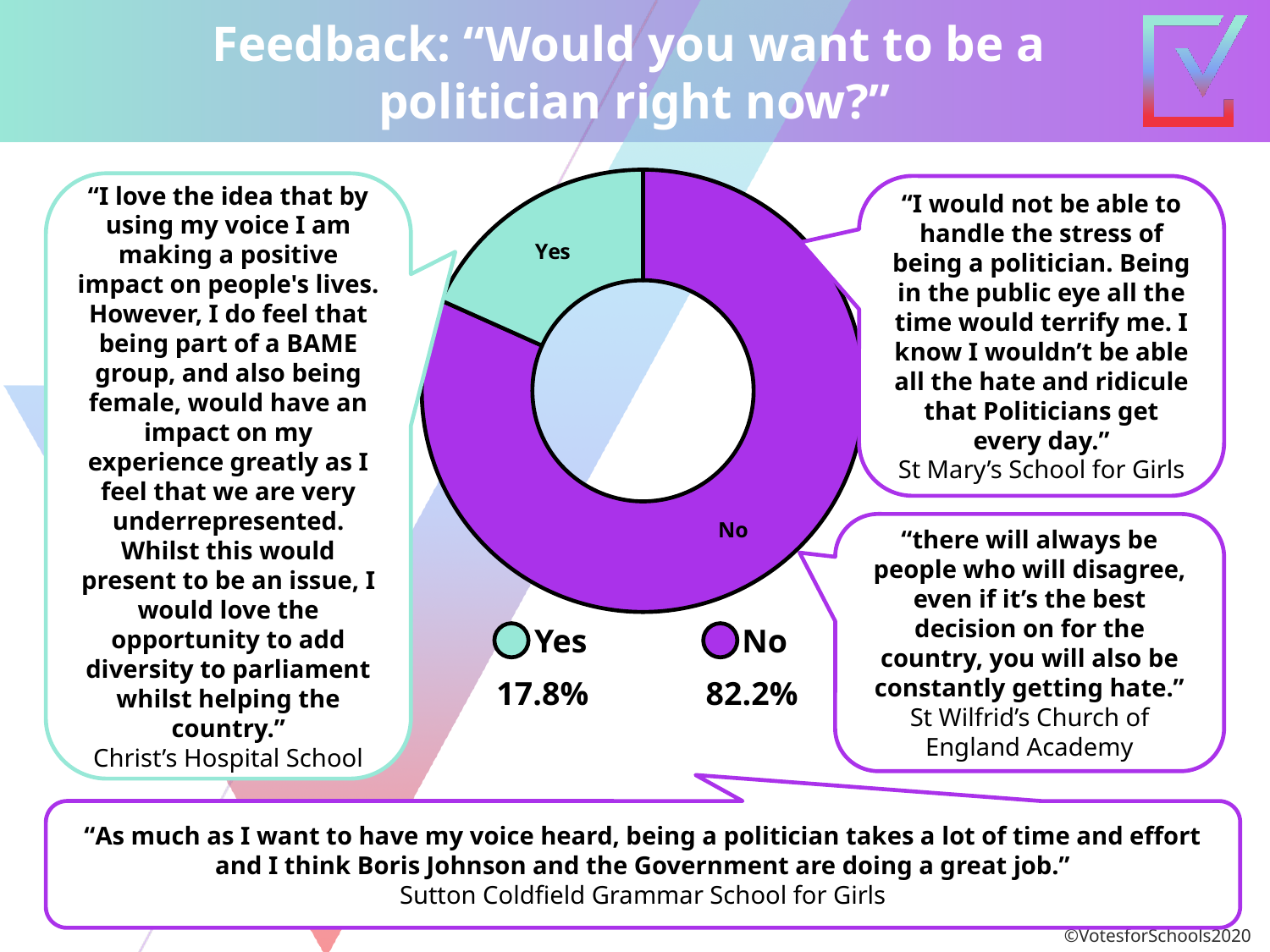
How many entries does the legend list? 2 What kind of chart is shown on the slide? Pie chart (doughnut) What is the total of the two percentages shown in the chart? 100% Which is larger, the share for "Yes" or the share for "No"? No What question does the chart's feedback relate to, according to the slide title? "Would you want to be a politician right now?" How many categories are shown in the chart? 2 Which response has the smallest share of the chart? Yes What percentage of respondents answered "No"? 82.2% What percentage of respondents answered "Yes"? 17.8% Which response has the largest share of the chart? No What colour represents the "No" response in the chart? Purple What is the difference in percentage points between the "No" and "Yes" responses? 64.4